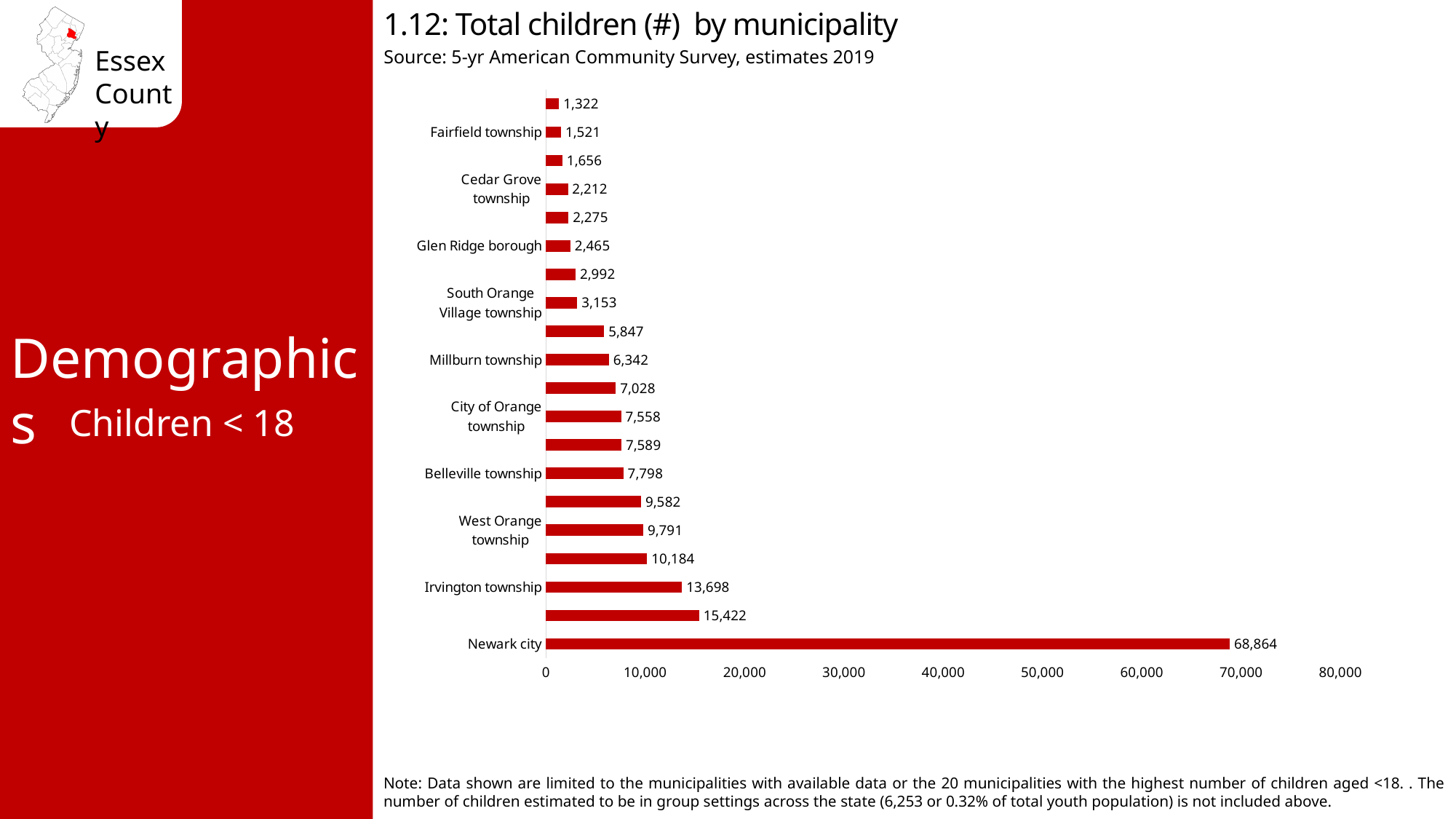
What is the difference between the values for Belleville township and Millburn township? 1,456 What is the total number of children for Fairfield township? 1,521 What is the total number of children for Newark city? 68,864 What is the difference between the values for Newark city and Irvington township? 55,166 What is the total number of children for Irvington township? 13,698 What is the smallest value shown on the chart? 1,322 How many bars are plotted on the chart? 20 What is the total number of children for Millburn township? 6,342 Which municipality has the highest number of children? Newark city Which has more children, Glen Ridge borough or Cedar Grove township? Glen Ridge borough What kind of chart is shown on the slide? bar chart Is the value for West Orange township greater or less than 10,000? less